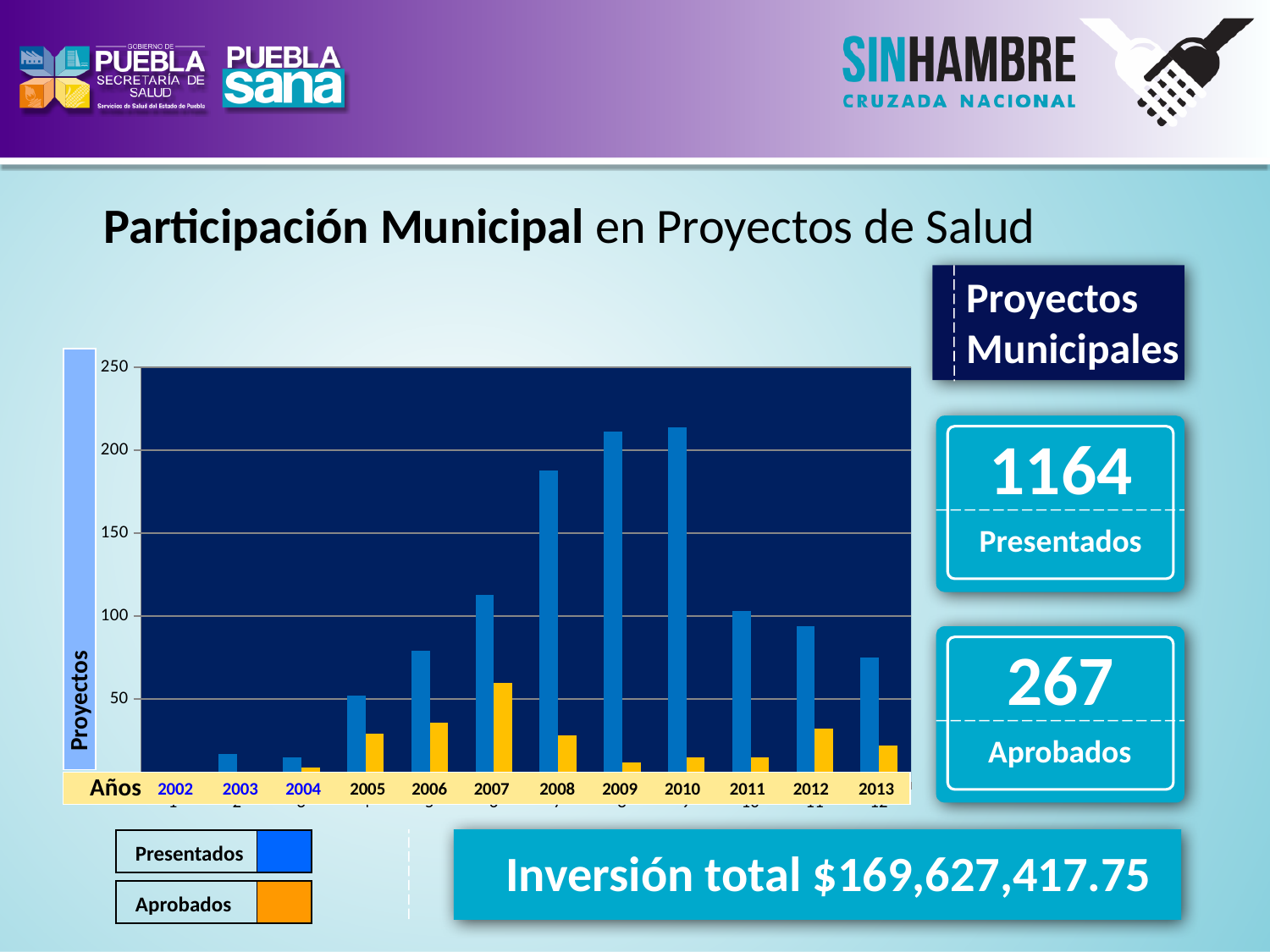
How many series does the legend list? 2 What kind of chart is shown on the slide? bar chart What colour represents the Aprobados series in the chart? orange How many years are shown along the x axis of the chart? 12 Is the Aprobados value for 2007 greater or less than 50? greater Which year has the larger Presentados value, 2012 or 2013? 2012 Is the Presentados value for 2009 greater or less than 200? greater Do the Presentados values rise or fall from 2010 to 2013? fall Which year has the highest Aprobados value? 2007 Is the Presentados value for 2008 greater or less than 150? greater Which year has the larger Presentados value, 2007 or 2008? 2008